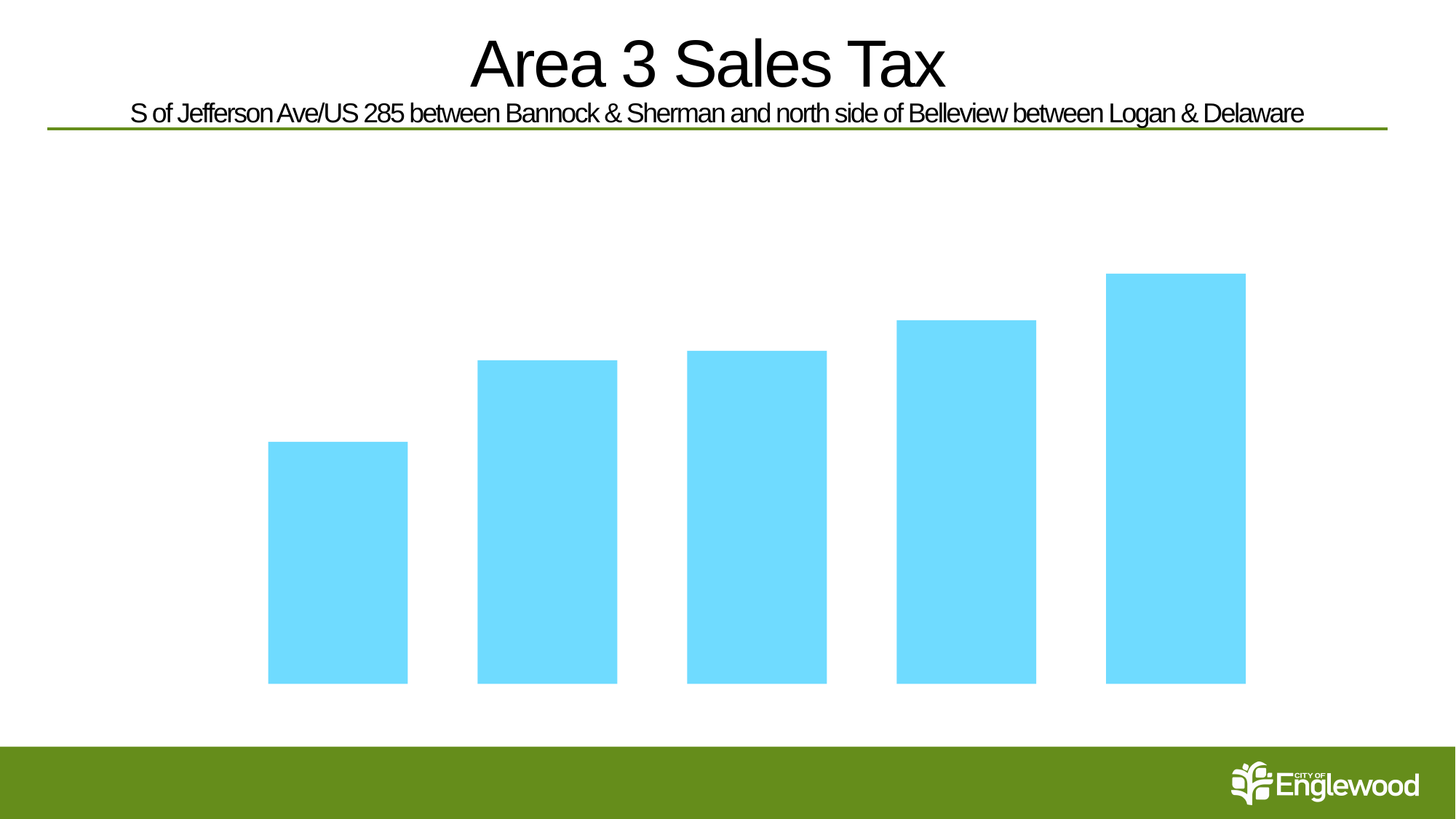
What kind of chart is shown on the slide? bar chart Which is taller, the first bar from the left or the third bar from the left? third bar from the left Which is taller, the second bar from the left or the fourth bar from the left? fourth bar from the left What colour are the bars in the chart? light blue Do the bar values rise or fall from left to right across the chart? rise Which bar is the tallest: the leftmost or the rightmost? rightmost Which bar is the shortest: the leftmost or the rightmost? leftmost How many bars does the chart show? 5 What is the title of the slide containing the chart? Area 3 Sales Tax